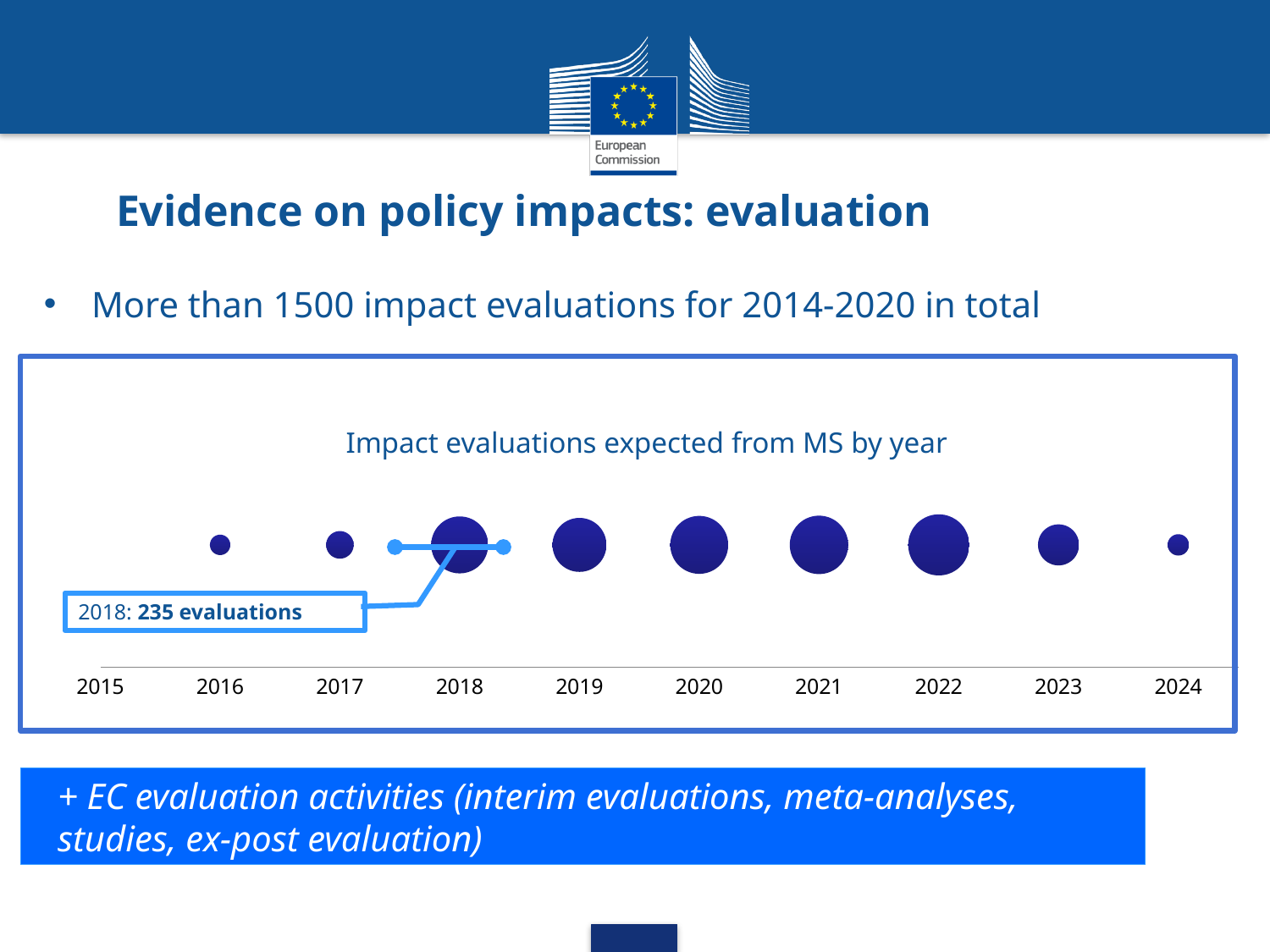
Which year has the larger bubble, 2022 or 2023? 2022 Do the bubble sizes rise or fall from 2022 to 2024? fall Which year is the first on the chart's x axis? 2015 What is the title of the chart? Impact evaluations expected from MS by year What kind of chart is shown on the slide? bubble chart How many impact evaluations are expected in 2018 according to the chart's callout? 235 evaluations Which year is the last on the chart's x axis? 2024 How many years are labelled on the x axis of the chart? 10 Do the bubble sizes rise or fall from 2016 to 2018? rise Which year has the larger bubble, 2019 or 2024? 2019 Which year has the larger bubble, 2017 or 2020? 2020